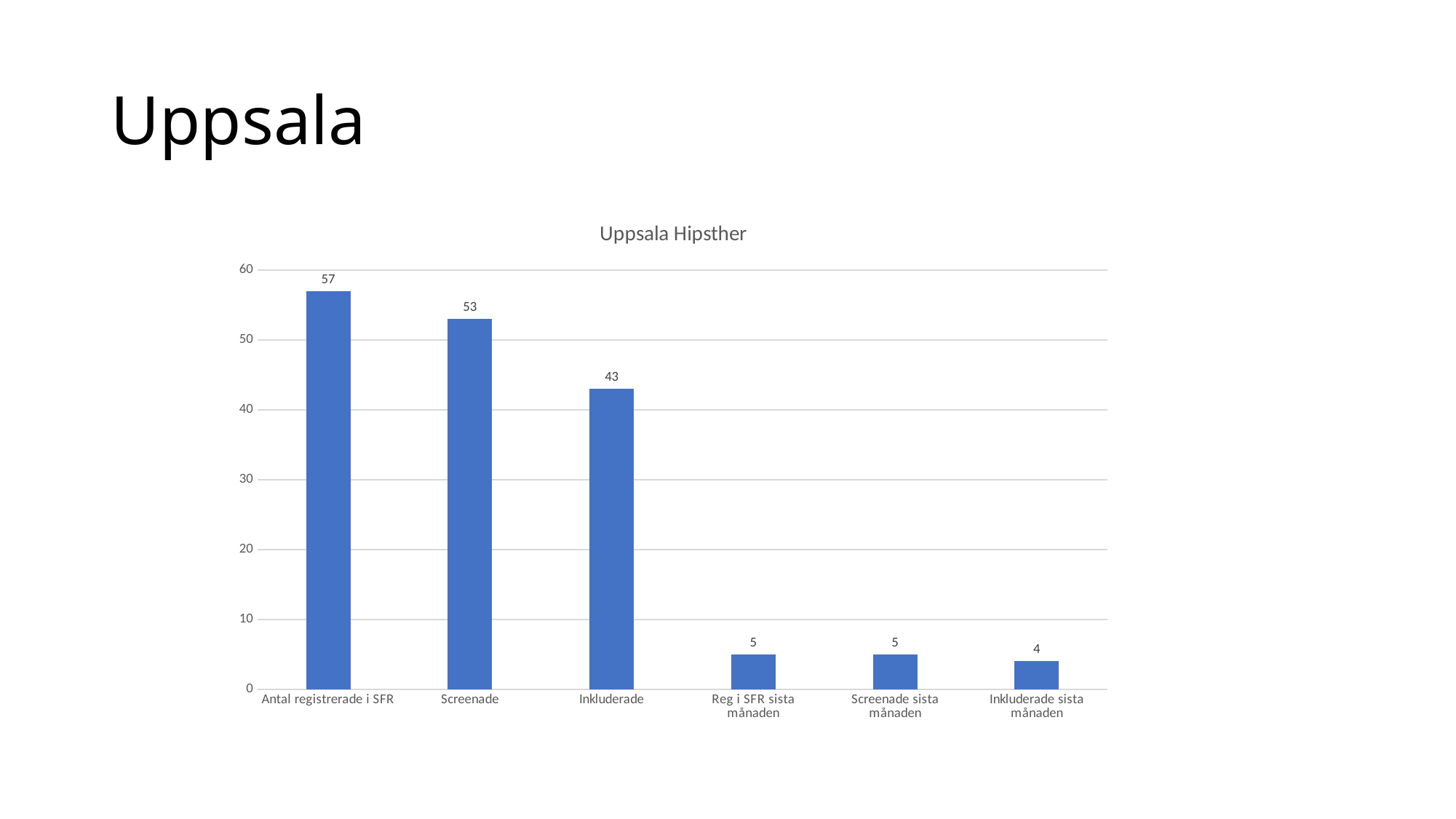
What is the title of the chart? Uppsala Hipsther What is the value for Screenade? 53 What is the value for Inkluderade sista månaden? 4 What kind of chart is shown on the slide? bar chart Which category has the highest value? Antal registrerade i SFR Which is larger, the value for Antal registrerade i SFR or the value for Screenade? Antal registrerade i SFR What is the value for Inkluderade? 43 How many categories are shown on the x axis? 6 Which category has the lowest value? Inkluderade sista månaden What is the value for Antal registrerade i SFR? 57 What is the difference between the values for Screenade and Inkluderade? 10 Is the value for Inkluderade greater or less than 40? greater